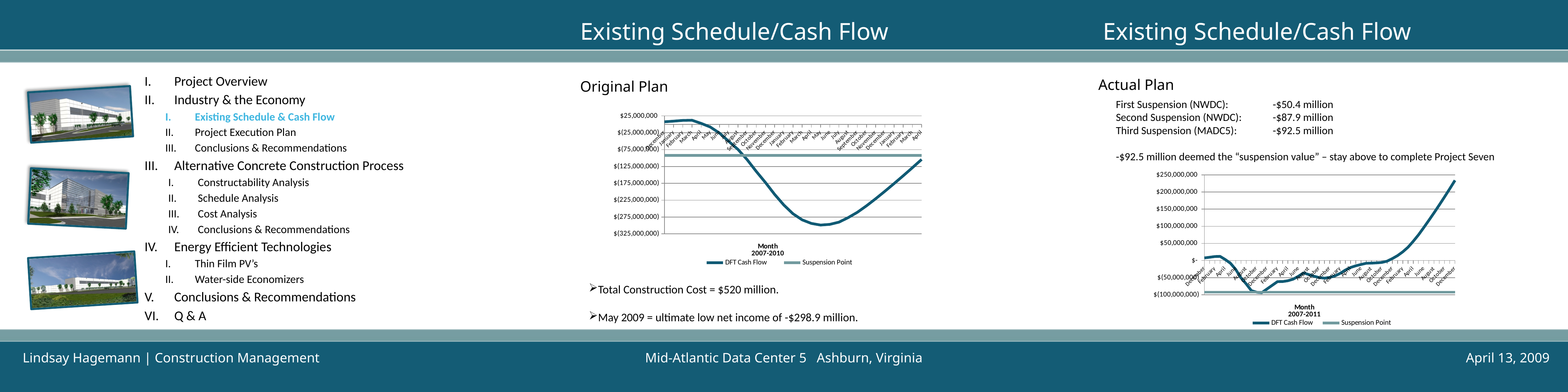
What kind of chart is the Actual Plan chart? line chart What is the x-axis title of the Actual Plan chart? Month 2007-2011 In the Actual Plan chart, is the final value of the DFT Cash Flow line greater or less than $200,000,000? greater How many series does the legend of the Actual Plan chart list? 2 What kind of chart is the Original Plan chart? line chart In the Actual Plan chart, does the DFT Cash Flow line rise or fall over the last year shown on the x axis? rises In the Original Plan chart, is the lowest point of the DFT Cash Flow line greater or less than $(275,000,000)? less How many series does the legend of the Original Plan chart list? 2 In the Original Plan chart, does the DFT Cash Flow line rise or fall from the start of the x axis to May 2009? falls In the Original Plan chart, is the Suspension Point line greater or less than $(75,000,000)? less What are the two series named in the legend of the Actual Plan chart? DFT Cash Flow and Suspension Point